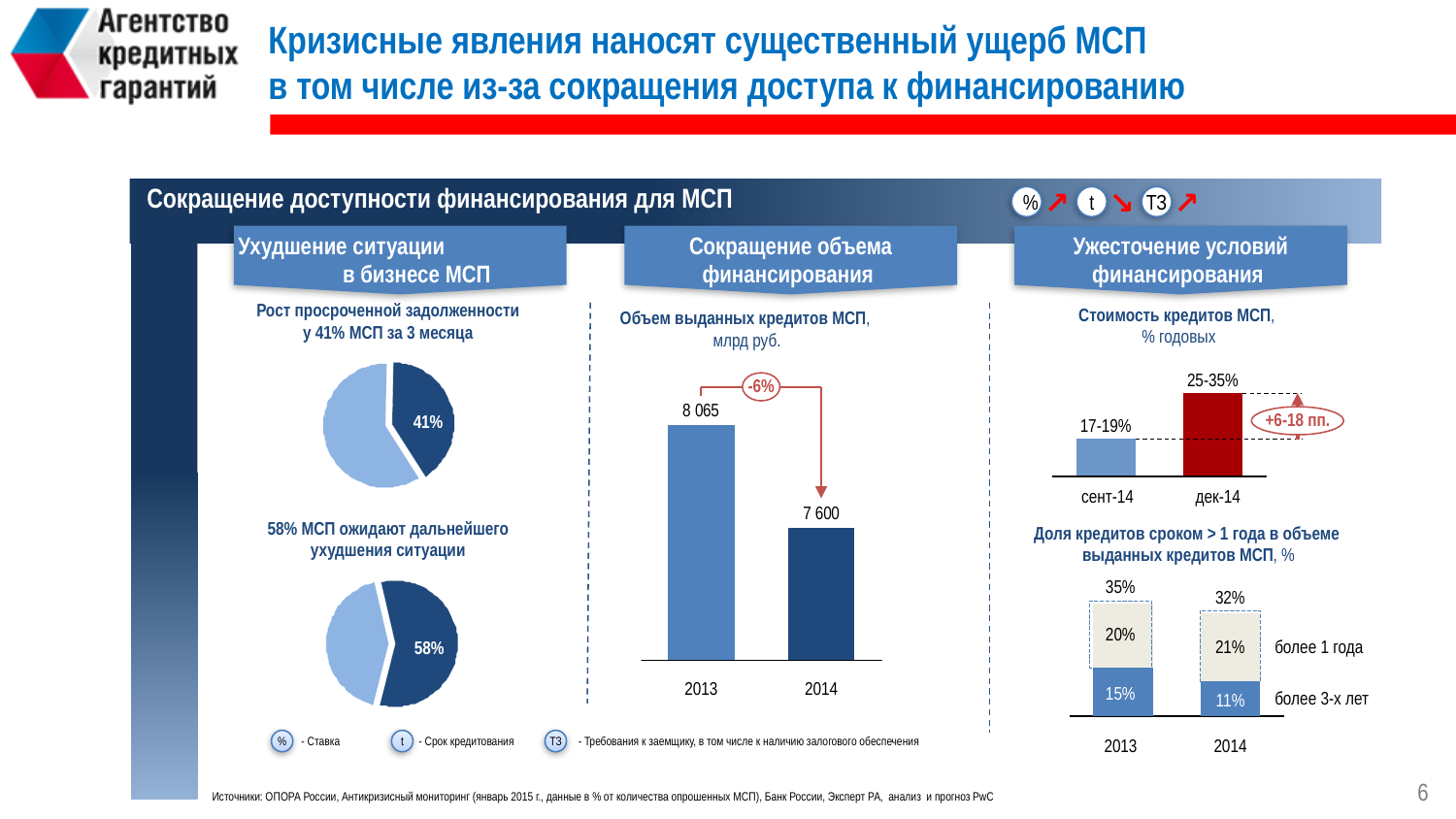
In the chart 'Доля кредитов сроком > 1 года в объеме выданных кредитов МСП, %', what is the value of 'более 1 года' for 2013? 20% In the chart 'Объем выданных кредитов МСП, млрд руб.', which year has the higher value? 2013 In the chart 'Стоимость кредитов МСП, % годовых', what is the value for сент-14? 17-19% In the chart 'Доля кредитов сроком > 1 года в объеме выданных кредитов МСП, %', what is the total for 2013? 35% In the chart 'Стоимость кредитов МСП, % годовых', what change is labelled between сент-14 and дек-14? +6-18 пп. In the chart 'Стоимость кредитов МСП, % годовых', what is the value for дек-14? 25-35% In the chart 'Объем выданных кредитов МСП, млрд руб.', what is the value for 2014? 7 600 In the chart 'Объем выданных кредитов МСП, млрд руб.', what is the value for 2013? 8 065 In the chart 'Доля кредитов сроком > 1 года в объеме выданных кредитов МСП, %', what is the value of 'более 3-х лет' for 2014? 11% In the pie chart under 'Рост просроченной задолженности у 41% МСП за 3 месяца', what share is shown for the dark blue slice? 41% In the chart 'Объем выданных кредитов МСП, млрд руб.', what percentage change between 2013 and 2014 is labelled on the chart? -6% In the chart 'Объем выданных кредитов МСП, млрд руб.', what is the difference between the 2013 and 2014 values? 465